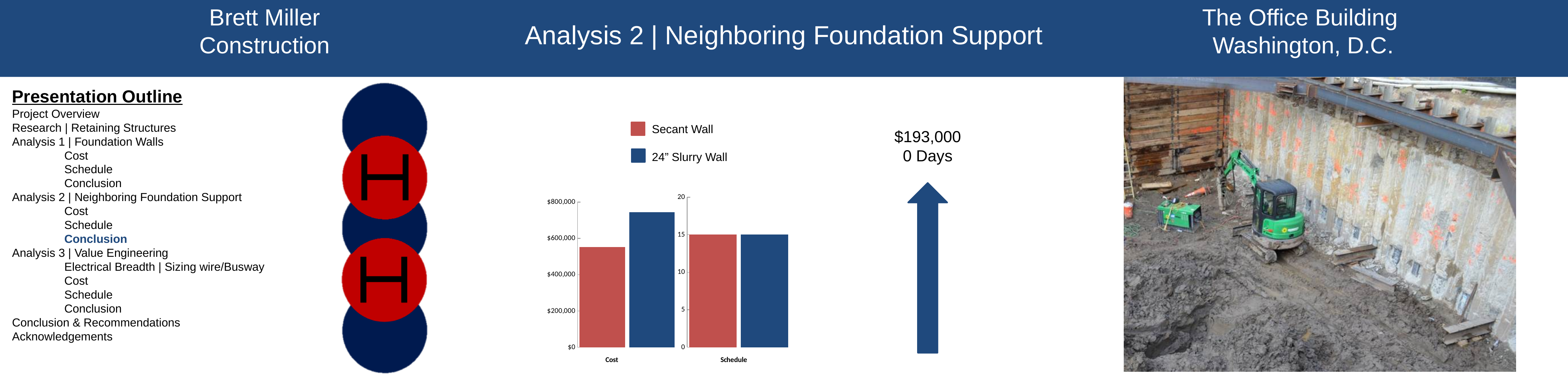
What are the two categories labelled on the x axis of the chart? Cost and Schedule Is the Cost value for Secant Wall greater or less than $600,000? less Which series is shown in red in the chart legend? Secant Wall Is the Cost value for Secant Wall greater or less than $400,000? greater How many series does the chart legend list? 2 What kind of chart is shown on the slide? bar chart Is the Schedule value for Secant Wall greater or less than 10? greater How many categories are shown on the x axis of the chart? 2 Which series has the higher Cost bar, Secant Wall or 24" Slurry Wall? 24" Slurry Wall